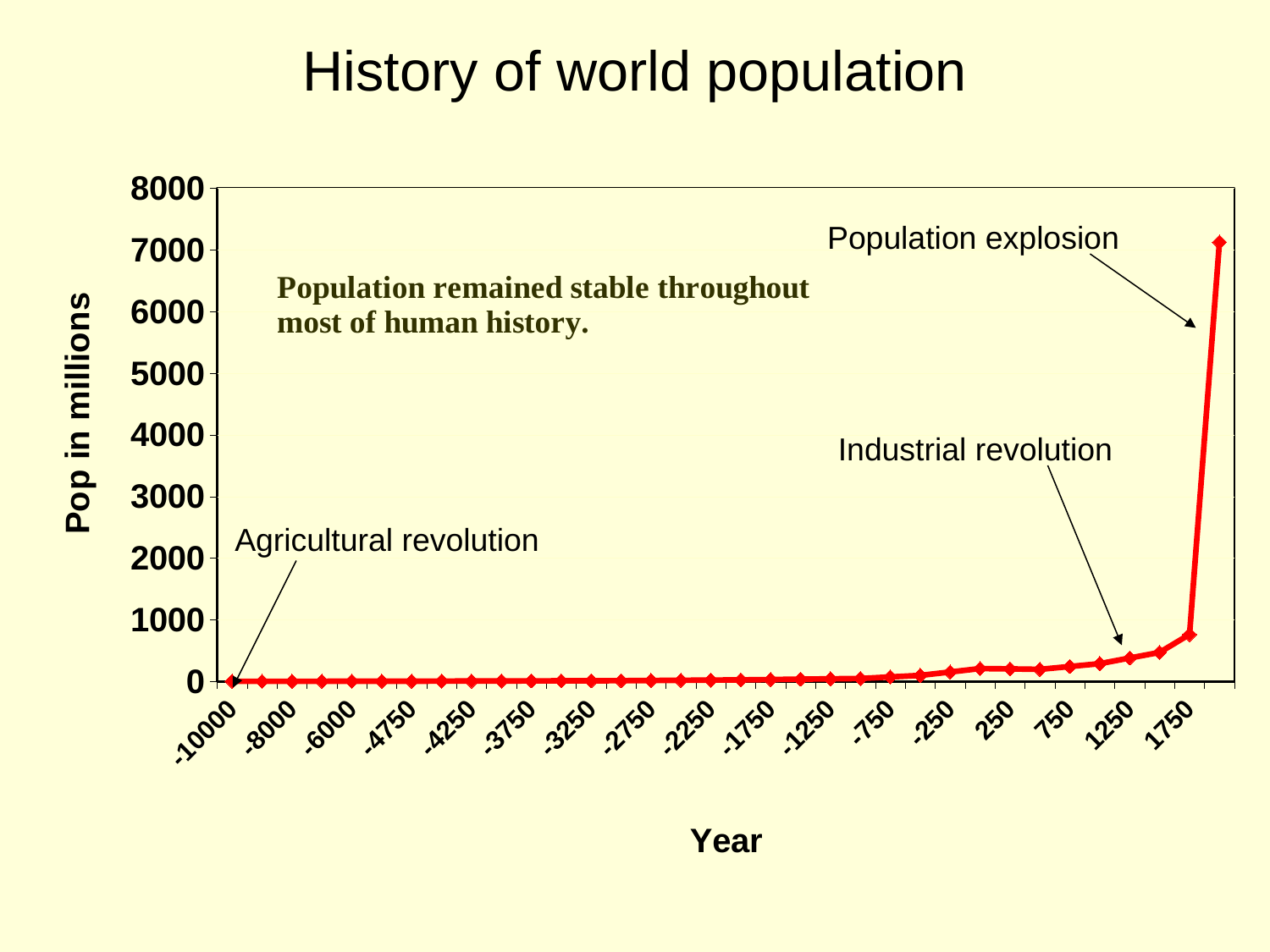
Which is larger, the population value at 1750 or at -8000? 1750 Which point on the line has the highest population value? the last (rightmost) point, after 1750 What is the label of the vertical axis? Pop in millions Which is larger, the population value at 1250 or at -1250? 1250 What is the highest value shown on the vertical axis? 8000 Is the value for the last (rightmost) point greater or less than 6000? greater What is the title of the chart on the slide? History of world population Is the value for the year 250 greater or less than 1000? less Overall, do the population values rise or fall from left to right along the x axis? rise What kind of chart is shown on the slide? line chart Is the value for the year 1750 greater or less than 1000? less